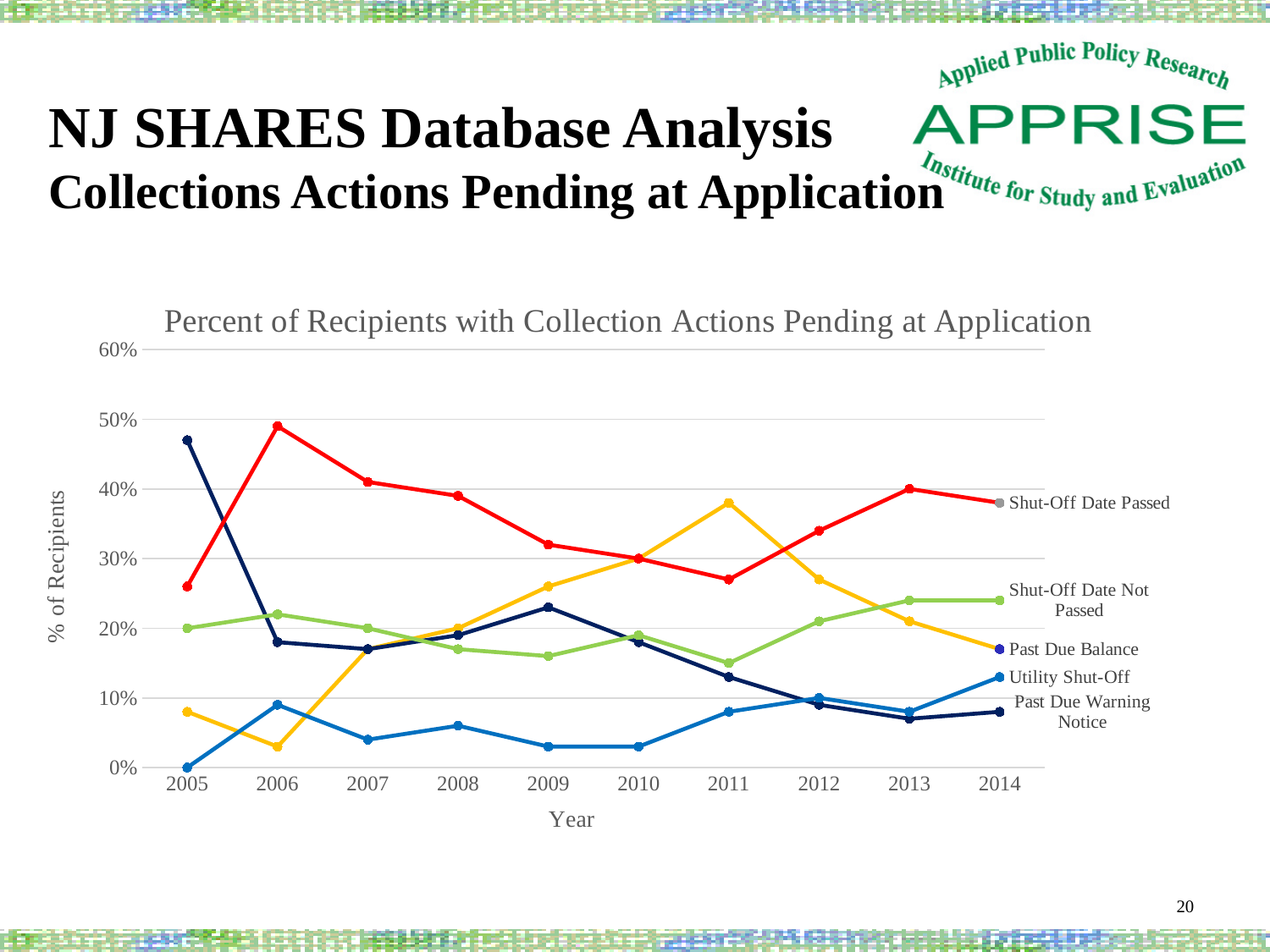
What kind of chart is shown on the slide? line chart Is the value for Shut-Off Date Passed in 2006 greater or less than 40%? greater Which series has the highest value in 2006? Shut-Off Date Passed How many years are plotted along the x axis? 10 In 2014, which is higher: Shut-Off Date Passed or Past Due Balance? Shut-Off Date Passed What is the label of the y axis? % of Recipients Does the Past Due Warning Notice series rise or fall from 2005 to 2014? fall Is the value for Utility Shut-Off in 2009 greater or less than 10%? less Is the value for Past Due Balance in 2011 greater or less than 30%? greater How many series does the chart show? 5 What is the title of the chart? Percent of Recipients with Collection Actions Pending at Application